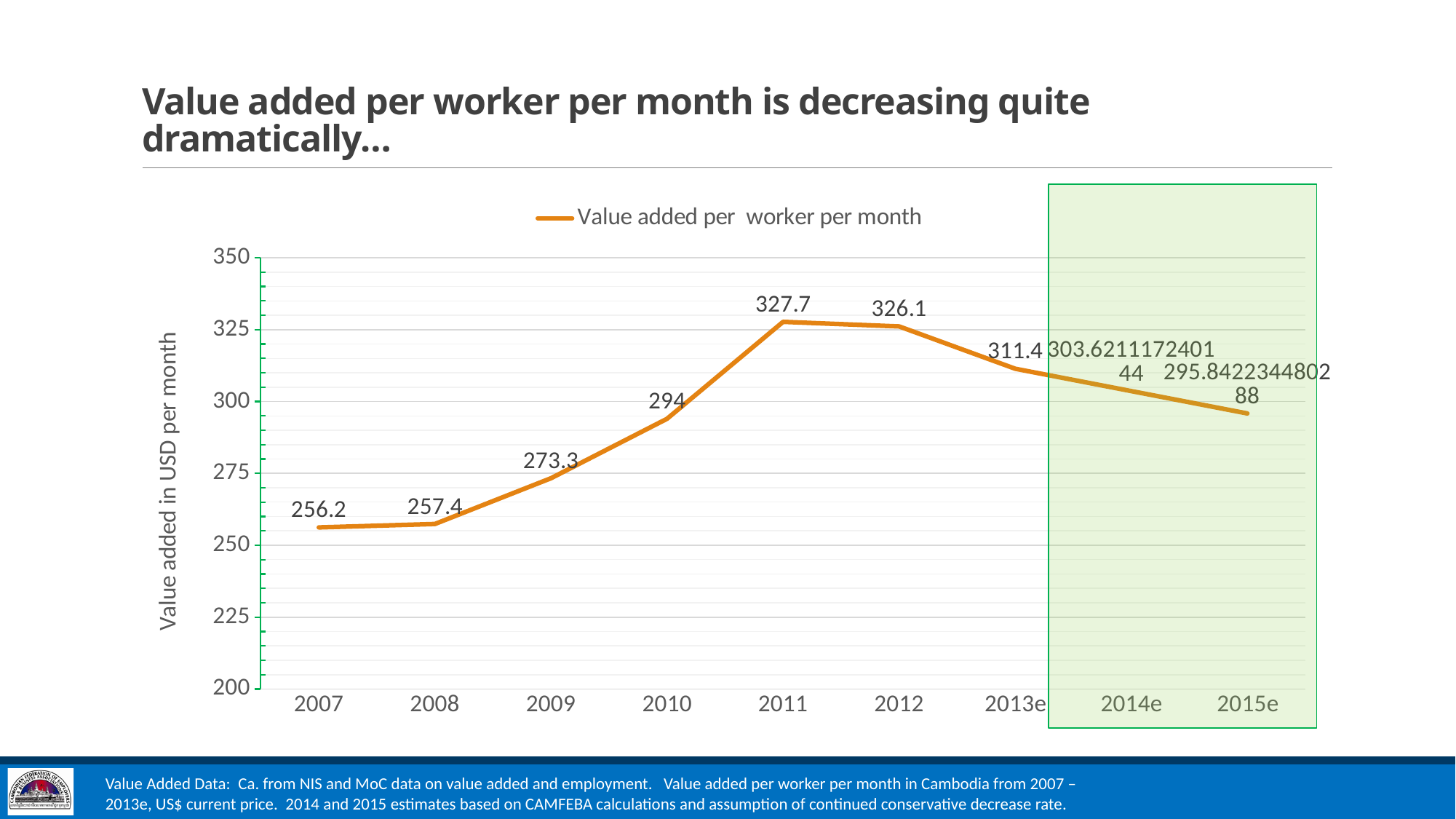
Does the value added per worker per month rise or fall from 2011 to 2015e? fall What type of chart is shown on the slide? line chart What is the label of the y axis? Value added in USD per month Which year has the lowest value added per worker per month? 2007 Which is larger, the value added per worker per month in 2009 or in 2012? 2012 What is the value added per worker per month in 2013e? 311.4 What is the difference between the value added per worker per month in 2011 and in 2010? 33.7 What is the value added per worker per month in 2007? 256.2 What is the value added per worker per month in 2011? 327.7 How many years are plotted on the x axis? 9 Is the value added per worker per month for 2015e greater or less than 300? less Which year has the highest value added per worker per month? 2011